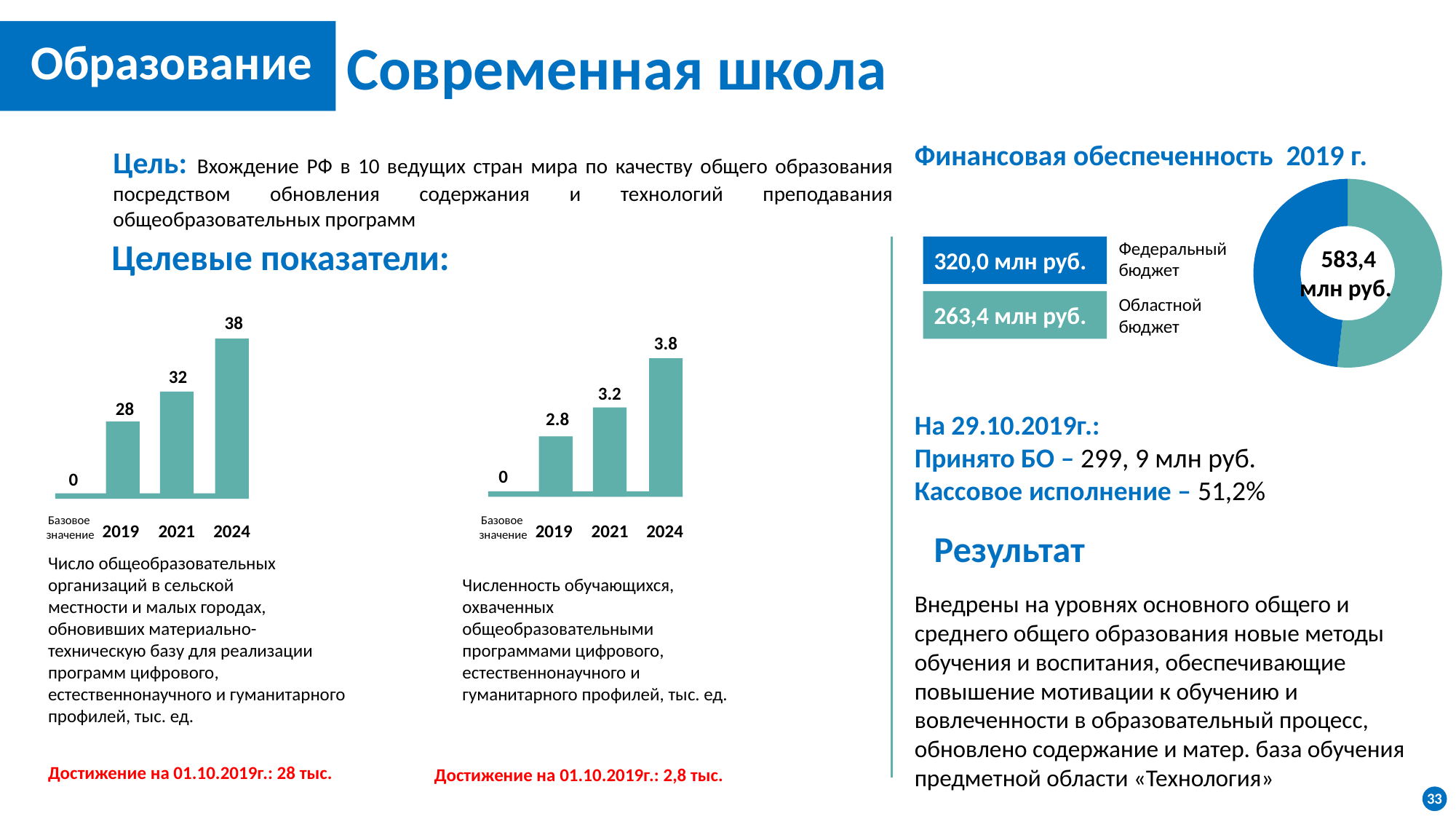
How many bars are shown on the left bar chart? 3 On the left bar chart, which category has the highest value? 2024 On the donut chart 'Финансовая обеспеченность 2019 г.', what is the value for Федеральный бюджет? 320,0 млн руб. On the middle bar chart, do the values rise or fall from the base value to 2024? rise On the donut chart 'Финансовая обеспеченность 2019 г.', what is the total shown in the centre? 583,4 млн руб. On the middle bar chart, what is the difference between the values for 2024 and 2019? 1.0 On the donut chart 'Финансовая обеспеченность 2019 г.', which is larger: Федеральный бюджет or Областной бюджет? Федеральный бюджет On the middle bar chart (number of students, тыс. ед.), what is the value for 2024? 3.8 On the left bar chart (number of general education organizations), what is the value for 2019? 28 On the left bar chart (number of general education organizations), what is the value for 2024? 38 On the middle bar chart (number of students, тыс. ед.), what is the value for 2021? 3.2 On the left bar chart, what is the difference between the values for 2024 and 2019? 10